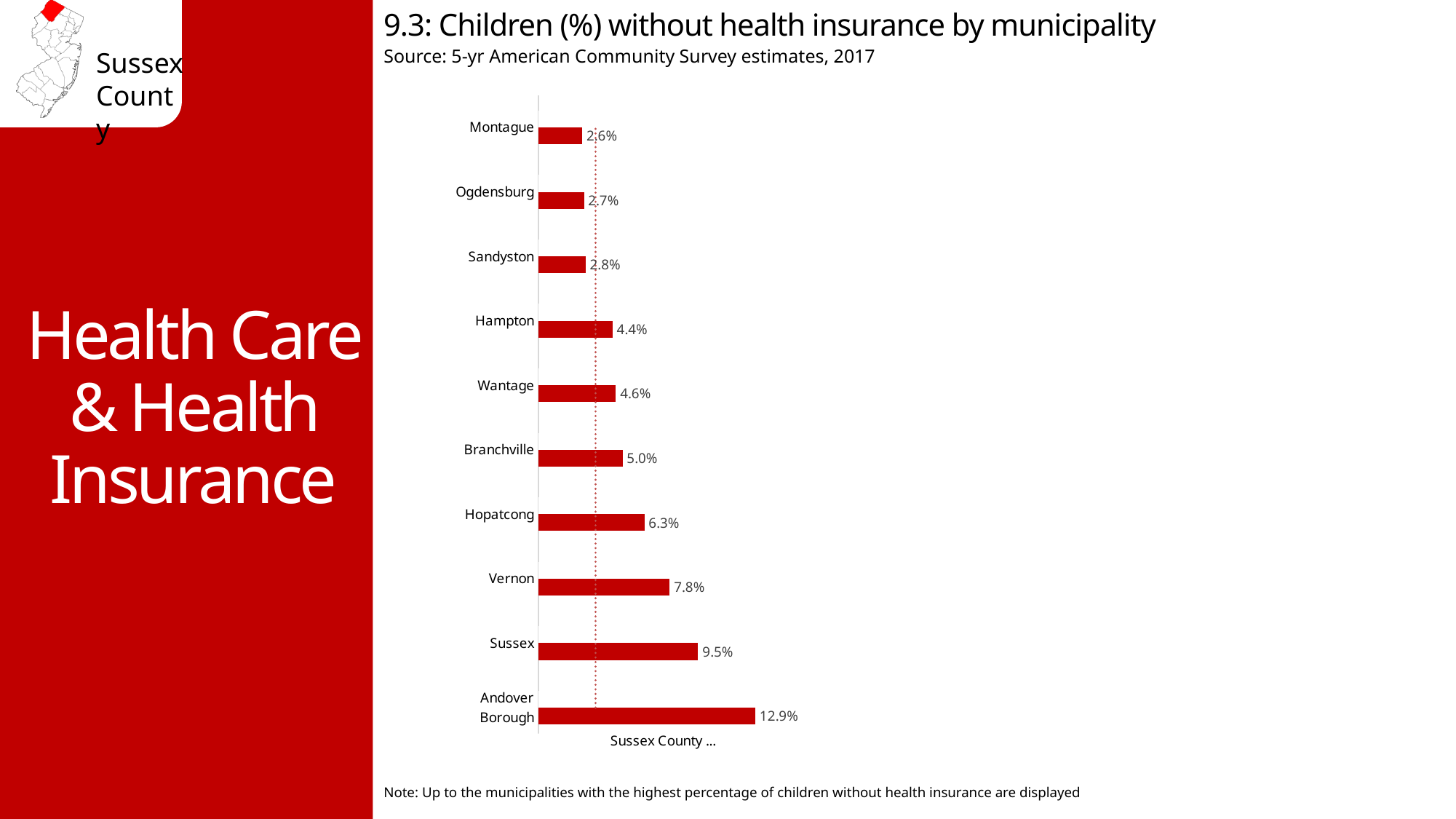
What percentage of children are without health insurance in Hopatcong? 6.3% What is the title of the chart? 9.3: Children (%) without health insurance by municipality What is the difference between the values for Sussex and Vernon? 1.7% Which municipality has the lowest percentage of children without health insurance? Montague What type of chart is shown on the slide? Bar chart What percentage is shown for Andover Borough? 12.9% How many municipalities are shown in the chart? 10 What is the difference between the values for Andover Borough and Montague? 10.3% Which has a higher value, Vernon or Hopatcong? Vernon Which has a higher value, Hampton or Branchville? Branchville Which municipality has the highest percentage of children without health insurance? Andover Borough What is the value shown for Wantage? 4.6%